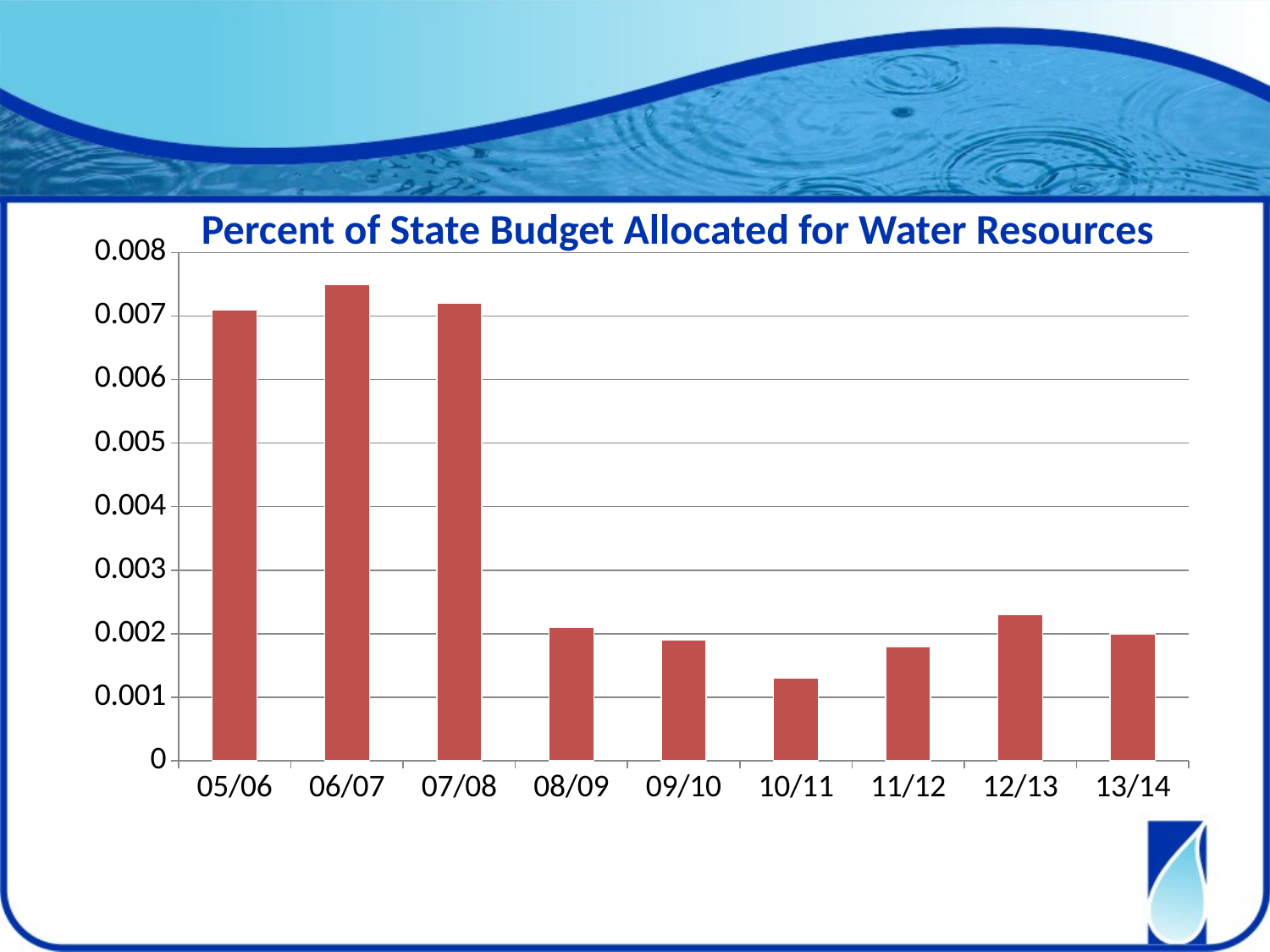
What type of chart is shown on the slide? Bar chart Which fiscal year has the lowest value in the chart? 10/11 Is the value for 11/12 greater or less than 0.002? less Which fiscal year has the highest value in the chart? 06/07 Is the value for 10/11 greater or less than 0.002? less Is the value for 05/06 greater or less than 0.006? greater What is the title of the chart? Percent of State Budget Allocated for Water Resources How many fiscal years are shown on the x axis of the chart? 9 Which is larger, the value for 12/13 or the value for 10/11? 12/13 Overall, do the values rise or fall from 05/06 to 13/14? fall Which is larger, the value for 05/06 or the value for 08/09? 05/06